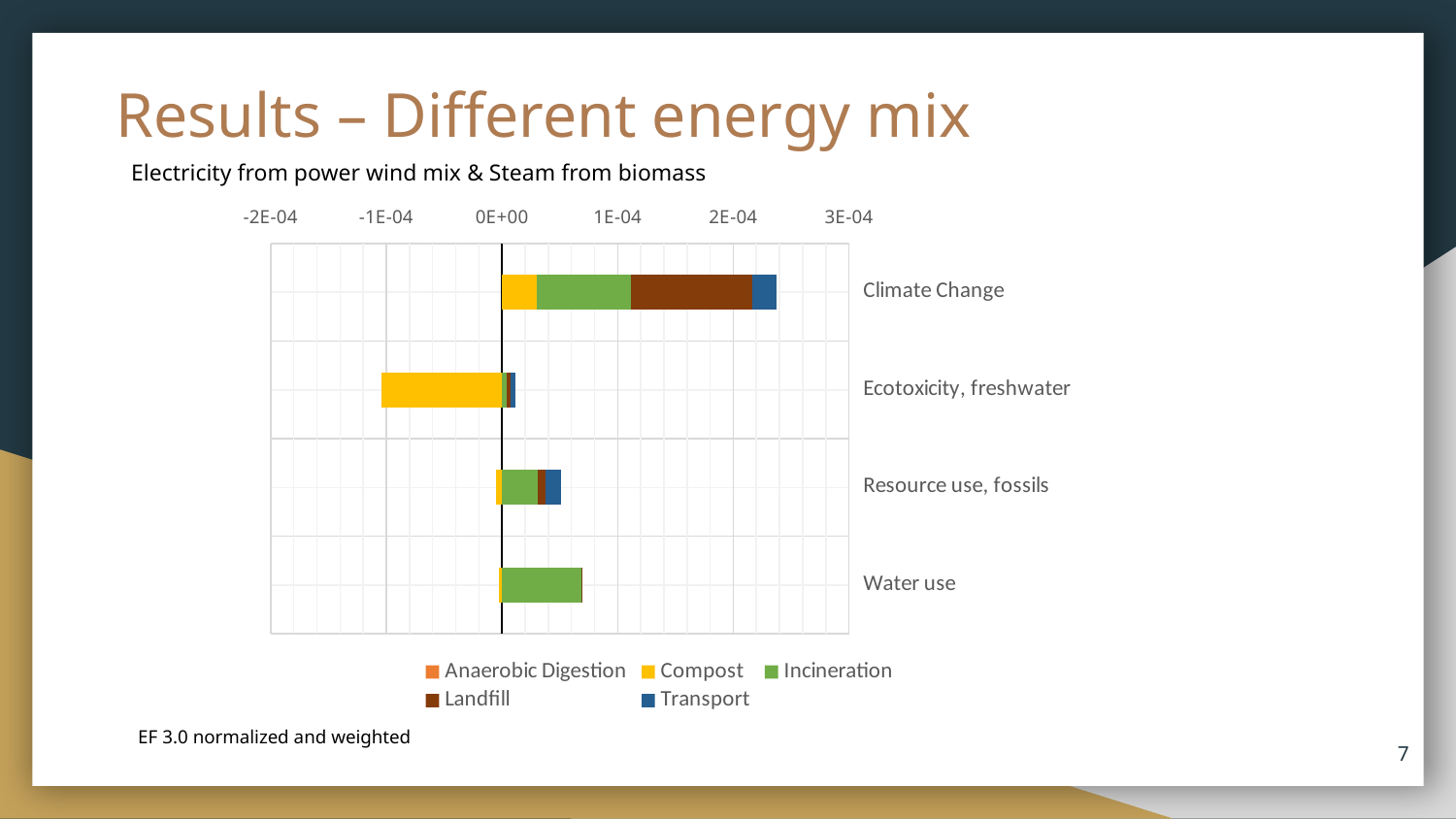
Which category has a large negative (left of zero) segment? Ecotoxicity, freshwater How many series does the chart legend list? 5 Is the positive value for Water use greater or less than 1E-04? less Which series forms the largest segment of the Climate Change bar? Landfill Which category has the longest positive stacked bar? Climate Change What is the title shown above the chart? Electricity from power wind mix & Steam from biomass How many impact categories are plotted on the chart? 4 Which is larger, the positive bar for Climate Change or the positive bar for Water use? Climate Change What kind of chart is shown on the slide? Stacked bar chart Is the positive value for Resource use, fossils greater or less than 1E-04? less Is the total positive value for Climate Change greater or less than 2E-04? greater Which series forms the largest segment of the Water use bar? Incineration